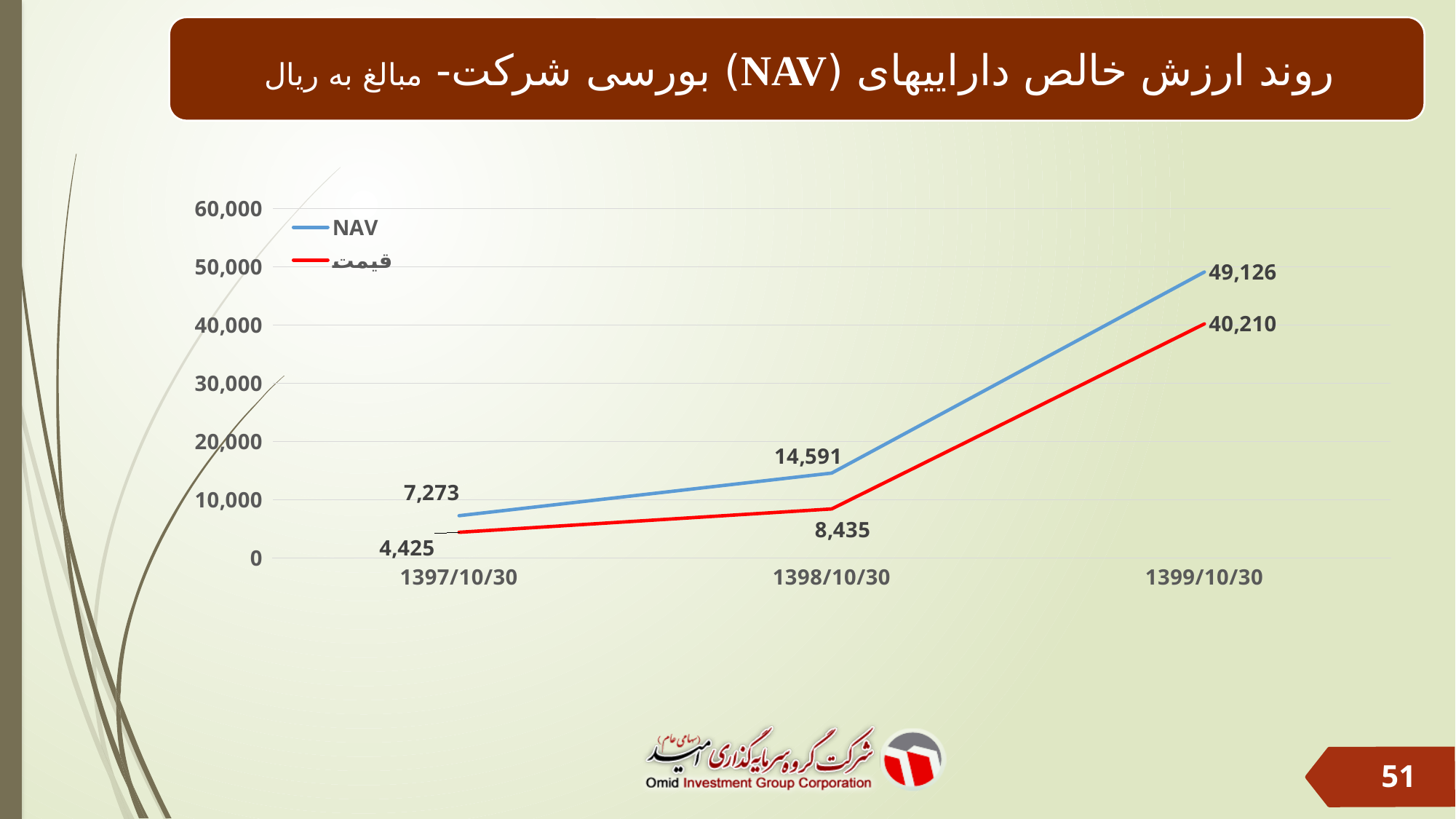
On which date is the NAV highest? 1399/10/30 What is the قیمت (price) value on 1397/10/30? 4,425 What is the قیمت (price) value on 1399/10/30? 40,210 On which date is the قیمت (price) lowest? 1397/10/30 How many dates are plotted on the x axis? 3 Which is larger on 1398/10/30, NAV or قیمت (price)? NAV How many series does the legend list? 2 What is the NAV value on 1399/10/30? 49,126 What kind of chart is shown on the slide? Line chart What is the difference between the NAV on 1398/10/30 and on 1397/10/30? 7,318 What is the difference between NAV and قیمت (price) on 1399/10/30? 8,916 What is the NAV value on 1398/10/30? 14,591